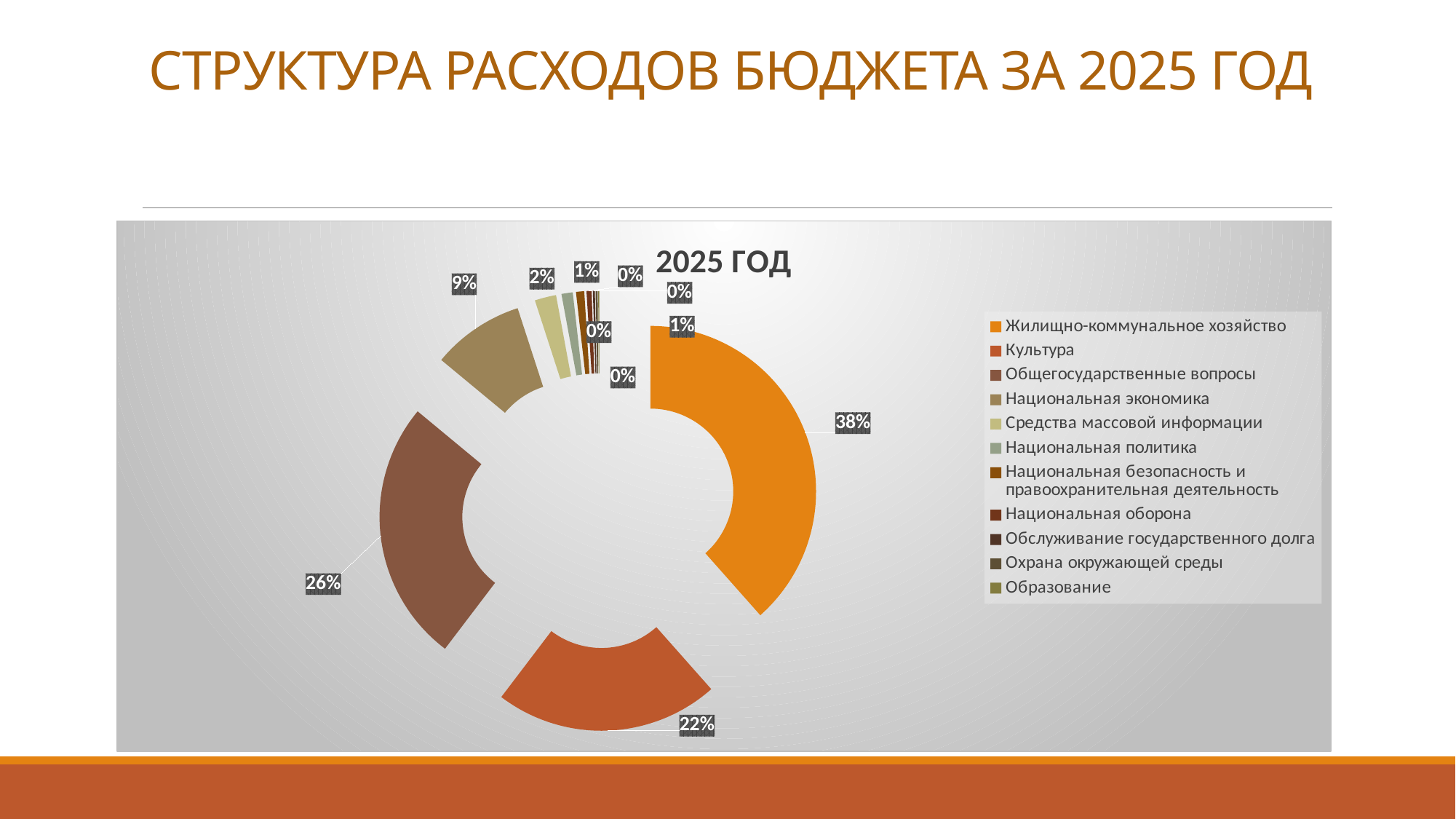
What is the value shown for Культура? 22% What is the value shown for Средства массовой информации? 2% What is the value shown for Общегосударственные вопросы? 26% What is the value shown for Национальная экономика? 9% Which is larger: the share for Культура or the share for Общегосударственные вопросы? Общегосударственные вопросы What is the title of the chart? 2025 ГОД What share of the budget expenditure goes to Жилищно-коммунальное хозяйство? 38% What kind of chart is shown on the slide? doughnut chart How many categories does the chart's legend list? 11 What colour represents Жилищно-коммунальное хозяйство in the chart? orange Which category has the largest share of the budget expenditure? Жилищно-коммунальное хозяйство What is the difference in percentage points between Жилищно-коммунальное хозяйство and Культура? 16